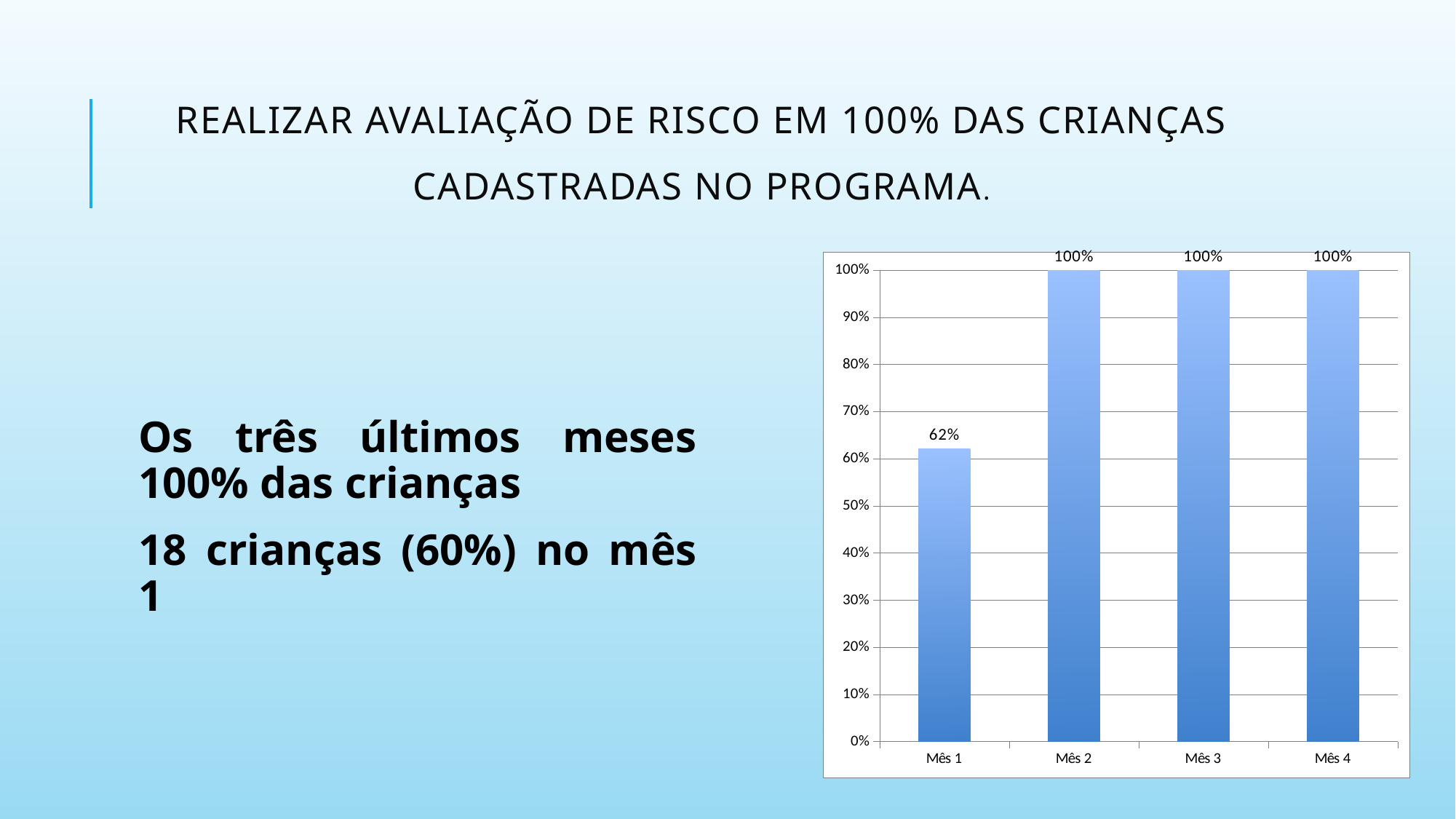
What is the value for Mês 1? 62% Which is larger, the value for Mês 1 or the value for Mês 3? Mês 3 Which month has the lowest value? Mês 1 What kind of chart is shown on the slide? bar chart What is the difference between the values for Mês 2 and Mês 1? 38% What is the value for Mês 4? 100% How many months are shown on the x axis? 4 How many months have a value of 100%? 3 Do the values rise or fall from Mês 1 to Mês 2? rise What is the value for Mês 2? 100% Is the value for Mês 1 greater or less than 70%? less What is the highest value shown on the y axis? 100%